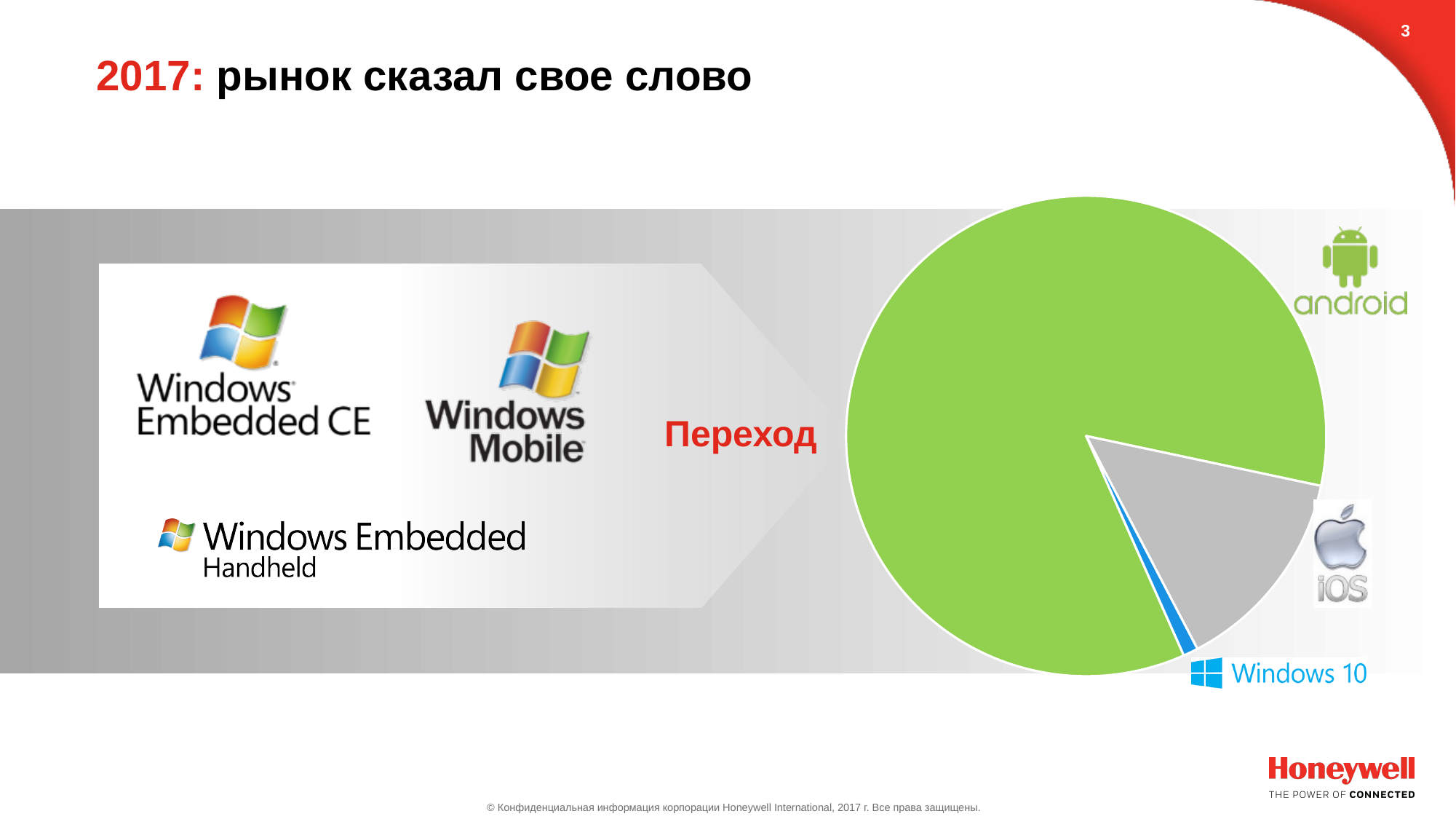
Which slice of the pie chart is the smallest? Windows 10 Which slice of the pie chart is the largest? Android How many slices does the pie chart have? 3 Which slice is larger in the pie chart, Android or iOS? Android What colour is the Android slice of the pie chart? green Which slice is larger in the pie chart, iOS or Windows 10? iOS What kind of chart is shown on the right side of the slide? pie chart What colour is the iOS slice of the pie chart? grey